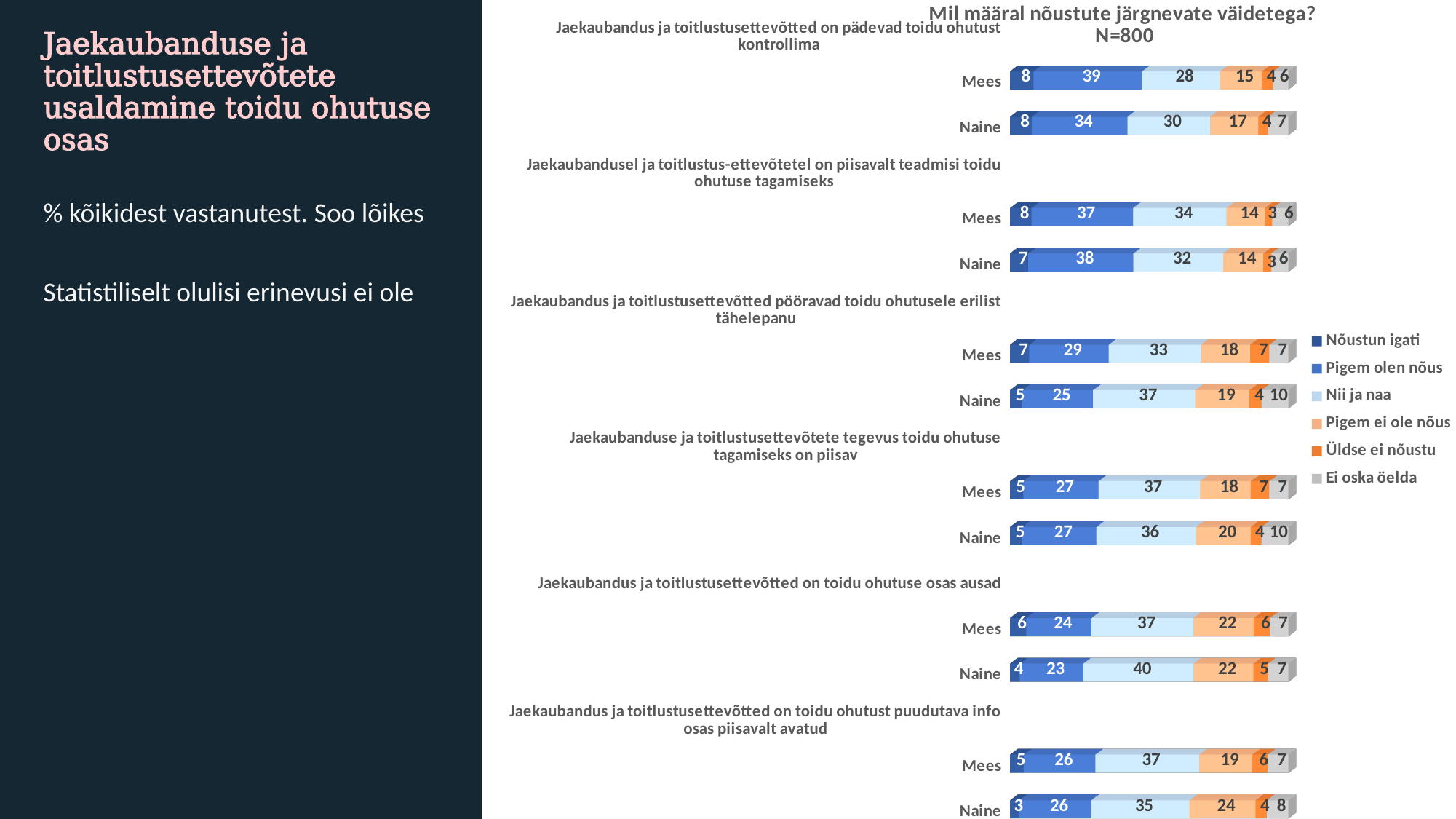
For the statement 'Jaekaubandus ja toitlustusettevõtted on pädevad toidu ohutust kontrollima', what is the total of the Mees bar? 100 For the statement 'Jaekaubandus ja toitlustusettevõtted on toidu ohutust puudutava info osas piisavalt avatud', what is the 'Pigem ei ole nõus' value for Naine? 24 For the statement 'Jaekaubandusel ja toitlustus-ettevõtetel on piisavalt teadmisi toidu ohutuse tagamiseks', which is larger for Mees: 'Pigem olen nõus' or 'Nii ja naa'? Pigem olen nõus For the statement 'Jaekaubandus ja toitlustusettevõtted pööravad toidu ohutusele erilist tähelepanu', what is the 'Ei oska öelda' value for Naine? 10 For the statement 'Jaekaubandus ja toitlustusettevõtted on pädevad toidu ohutust kontrollima', what is the difference between the 'Pigem olen nõus' values for Mees and Naine? 5 What type of chart is shown on the slide? Stacked bar chart For the statement 'Jaekaubandus ja toitlustusettevõtted on toidu ohutuse osas ausad', what is the 'Nii ja naa' value for Naine? 40 How many statements (question groups) are shown in the chart? 6 For the statement 'Jaekaubandus ja toitlustusettevõtted on pädevad toidu ohutust kontrollima', what is the 'Pigem olen nõus' value for Mees? 39 How many series does the legend list? 6 What is the N shown in the chart title? N=800 For the statement 'Jaekaubanduse ja toitlustusettevõtete tegevus toidu ohutuse tagamiseks on piisav', what is the difference between the 'Ei oska öelda' values for Naine and Mees? 3